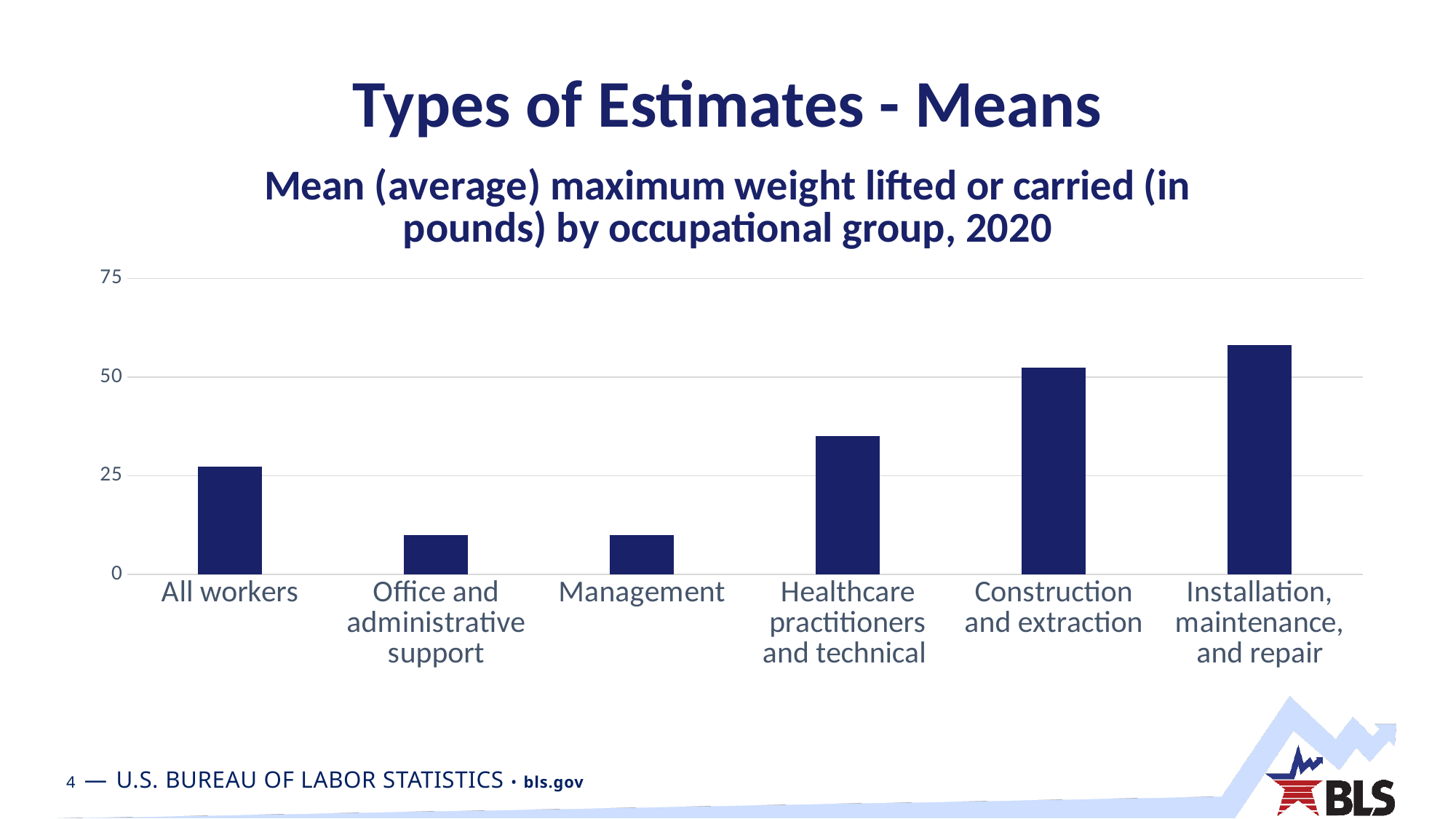
What kind of chart is shown on the slide? bar chart Is the value for Healthcare practitioners and technical greater or less than 25? greater Is the value for Installation, maintenance, and repair greater or less than 50? greater Is the value for Management greater or less than 25? less How many occupational groups (bars) are shown in the chart? 6 What is the title of the chart? Mean (average) maximum weight lifted or carried (in pounds) by occupational group, 2020 Which occupational group has the highest mean maximum weight lifted or carried? Installation, maintenance, and repair Which is larger, the value for Healthcare practitioners and technical or the value for All workers? Healthcare practitioners and technical Which is larger, the value for Construction and extraction or the value for Office and administrative support? Construction and extraction